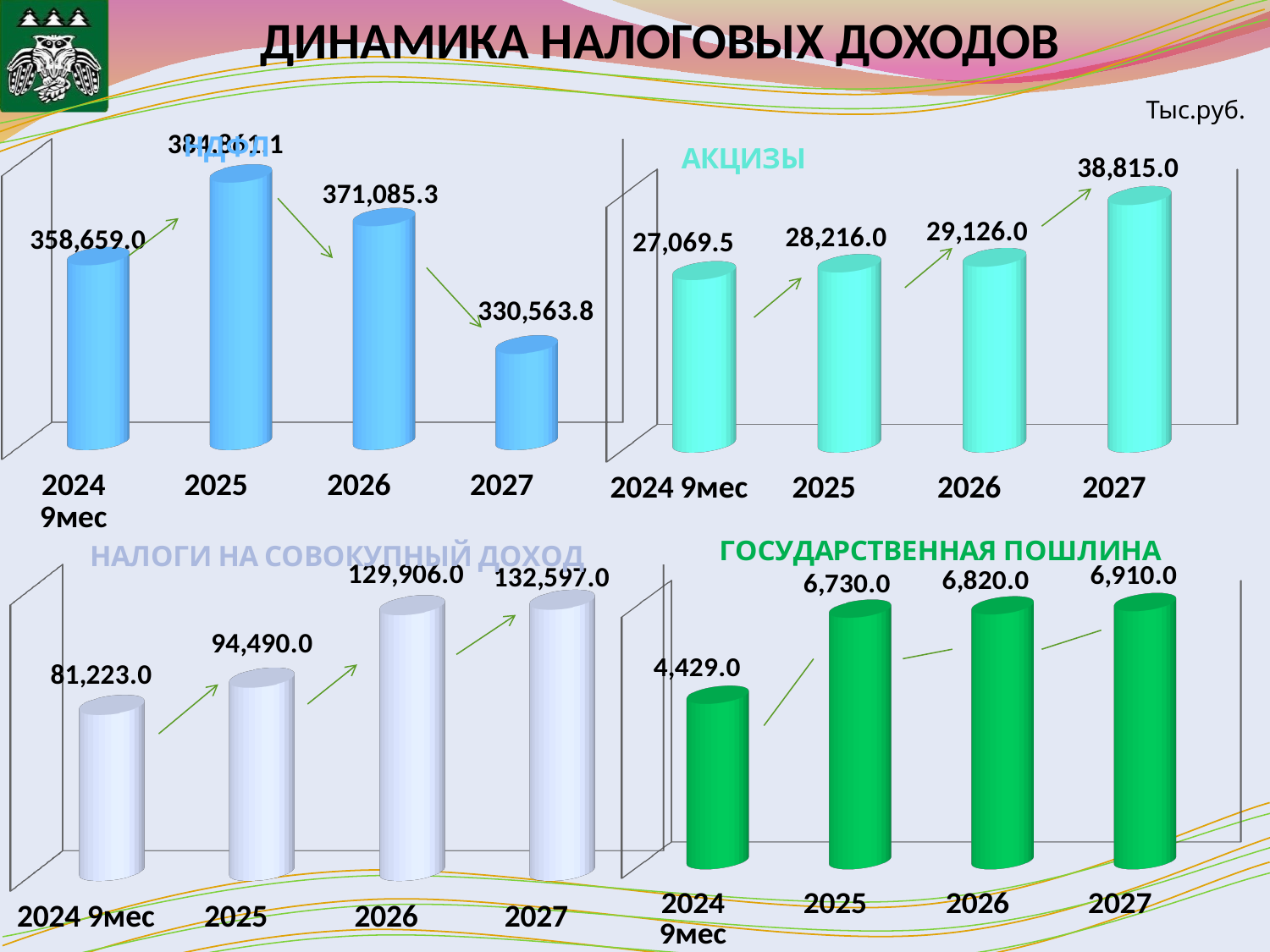
In the ГОСУДАРСТВЕННАЯ ПОШЛИНА chart, what is the value for 2024 9мес? 4,429.0 In the НДФЛ chart, which is larger: the value for 2024 9мес or the value for 2027? 2024 9мес In the АКЦИЗЫ chart, what is the value for 2027? 38,815.0 What kind of chart is the ГОСУДАРСТВЕННАЯ ПОШЛИНА chart? Bar chart In the АКЦИЗЫ chart, what is the difference between the 2027 and 2026 values? 9,689.0 In the НДФЛ chart, what is the value for 2026? 371,085.3 In the НАЛОГИ НА СОВОКУПНЫЙ ДОХОД chart, what is the value for 2025? 94,490.0 In the АКЦИЗЫ chart, do the values rise or fall from 2024 9мес to 2027? Rise In the НАЛОГИ НА СОВОКУПНЫЙ ДОХОД chart, which year has the highest value? 2027 How many bars are in the АКЦИЗЫ chart? 4 In the НДФЛ chart, which year has the lowest value? 2027 In the ГОСУДАРСТВЕННАЯ ПОШЛИНА chart, what is the difference between the 2025 and 2024 9мес values? 2,301.0